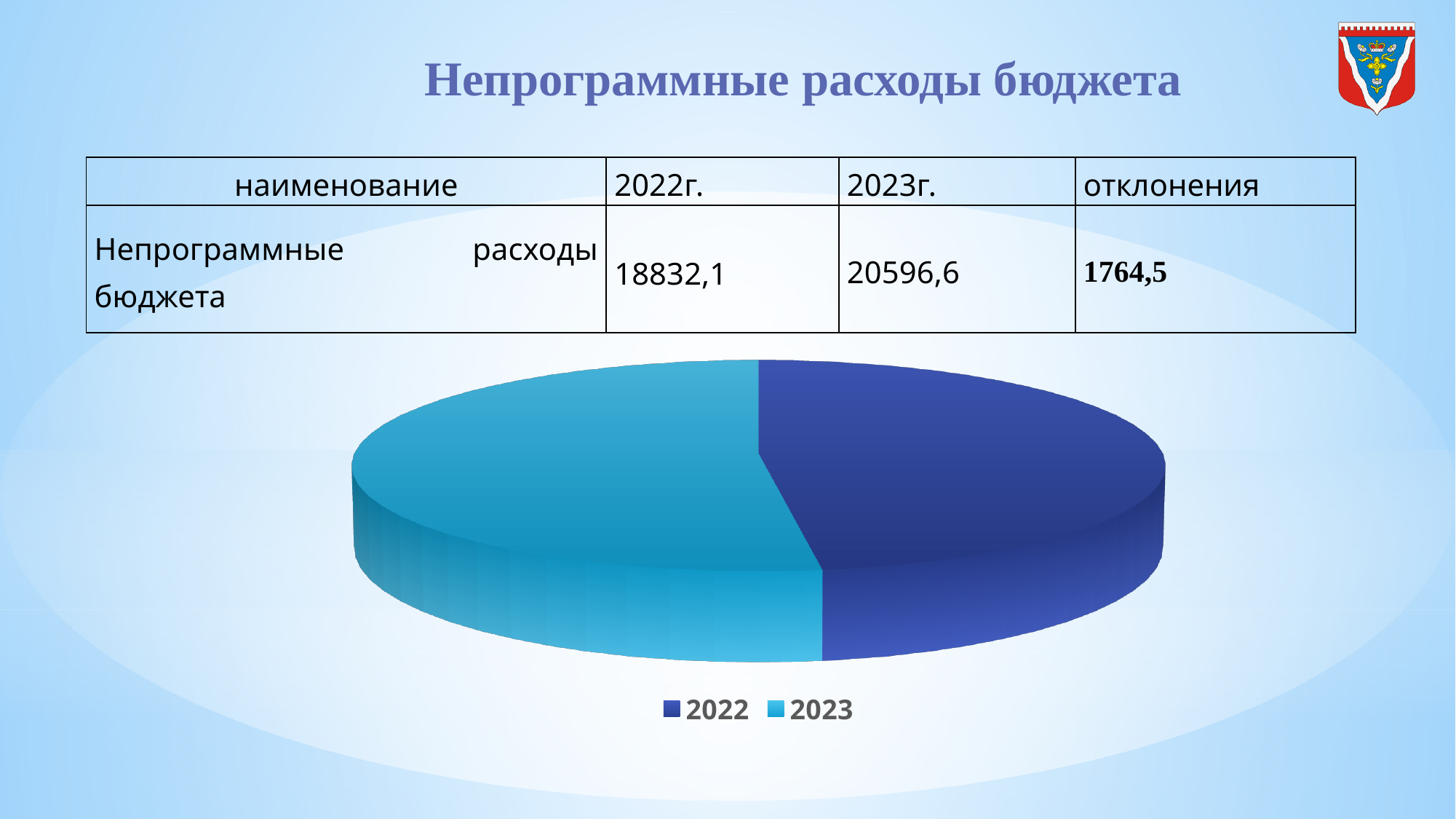
What colour is the 2022 slice in the pie chart? dark blue What is the value of non-programme budget expenditure (Непрограммные расходы бюджета) for 2023? 20596,6 How many entries does the legend of the pie chart list? 2 What is the title of the slide containing the pie chart? Непрограммные расходы бюджета What is the deviation (отклонения) between the 2023 and 2022 values? 1764,5 What kind of chart is shown on the slide? pie chart Which year has the larger slice in the pie chart, 2022 or 2023? 2023 How many slices does the pie chart have? 2 Which year has the smaller slice in the pie chart? 2022 What is the value of non-programme budget expenditure (Непрограммные расходы бюджета) for 2022? 18832,1